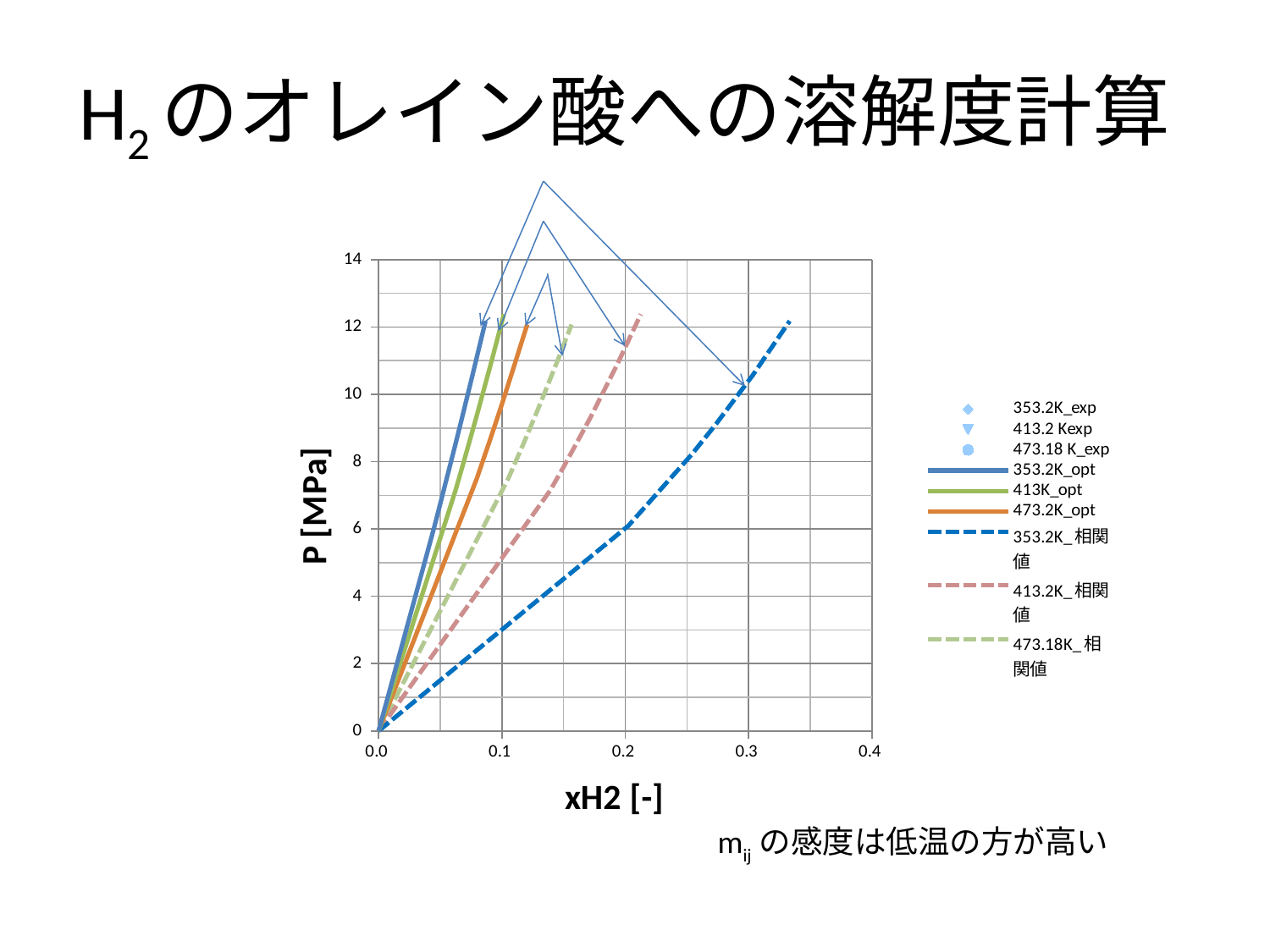
What kind of chart is shown on the slide? line chart Is the xH2 value where the 353.2K_相関値 line reaches about 12 MPa greater or less than 0.3? greater Which series extends to the largest xH2 value on the chart? 353.2K_相関値 What is the highest tick value shown on the y axis? 14 How many series does the legend list? 9 What is the label of the x axis? xH2 [-] Does P rise or fall as xH2 increases along the x axis for the plotted lines? rise At xH2 = 0.1, which series has the higher pressure, 353.2K_opt or 353.2K_相関値? 353.2K_opt At xH2 = 0.2, is the pressure of the 353.2K_相関値 line greater or less than 8 MPa? less Is the xH2 value where the 473.2K_opt line reaches about 12 MPa greater or less than 0.1? greater What is the label of the y axis? P [MPa]